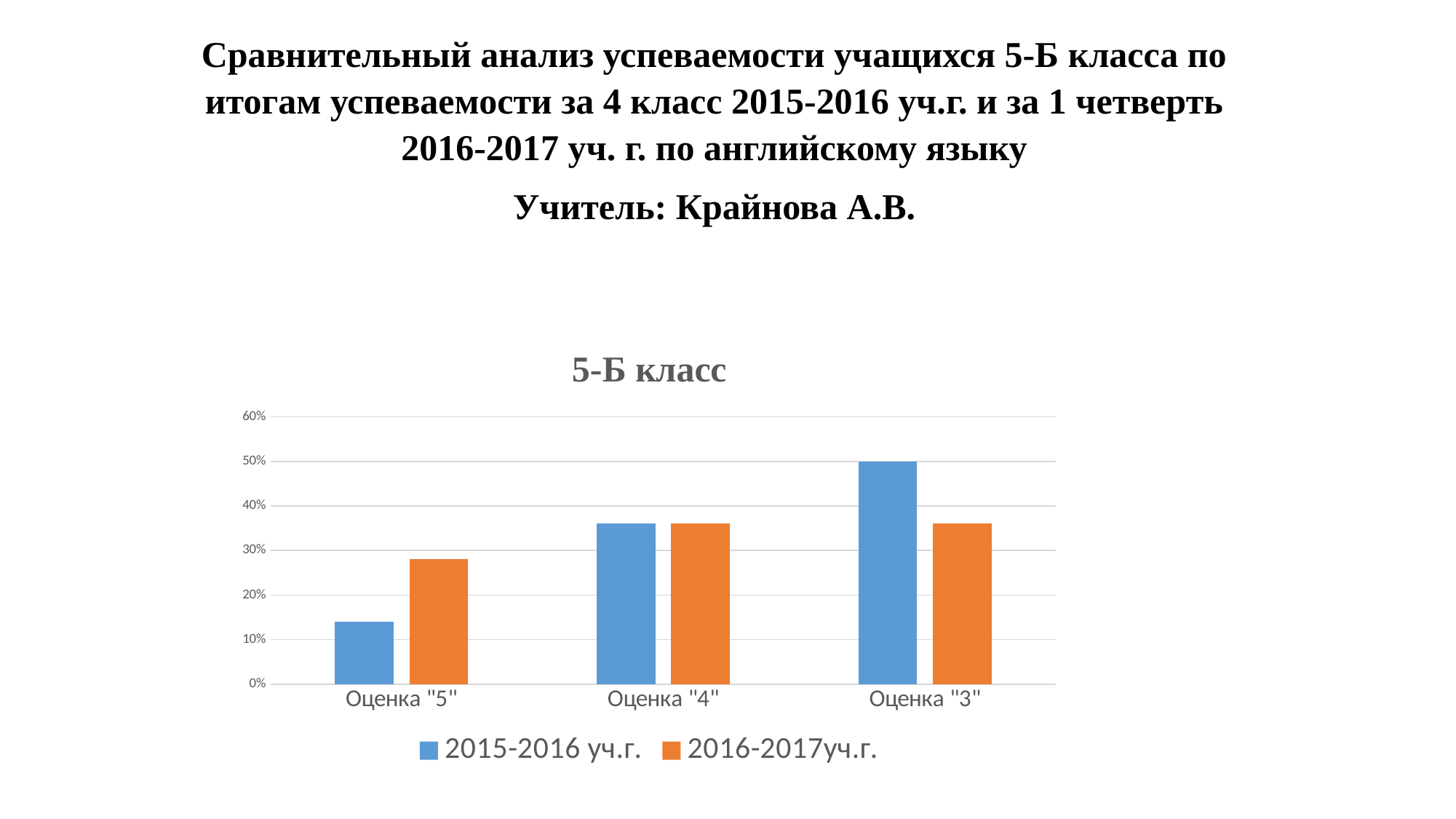
How many categories are shown on the x axis? 3 How many series does the legend list? 2 What is the value for Оценка "3" in the 2015-2016 уч.г. series? 50% What is the title of the chart? 5-Б класс Is the value for Оценка "5" in the 2016-2017уч.г. series greater or less than 20%? greater What kind of chart is shown on the slide? bar chart Is the value for Оценка "5" in the 2015-2016 уч.г. series greater or less than 20%? less For Оценка "5", which series has the larger value, 2015-2016 уч.г. or 2016-2017уч.г.? 2016-2017уч.г. Which category has the lowest value in the 2016-2017уч.г. series? Оценка "5" For Оценка "3", which series has the larger value, 2015-2016 уч.г. or 2016-2017уч.г.? 2015-2016 уч.г. Which category has the highest value in the 2015-2016 уч.г. series? Оценка "3" Is the value for Оценка "3" in the 2016-2017уч.г. series greater or less than 40%? less